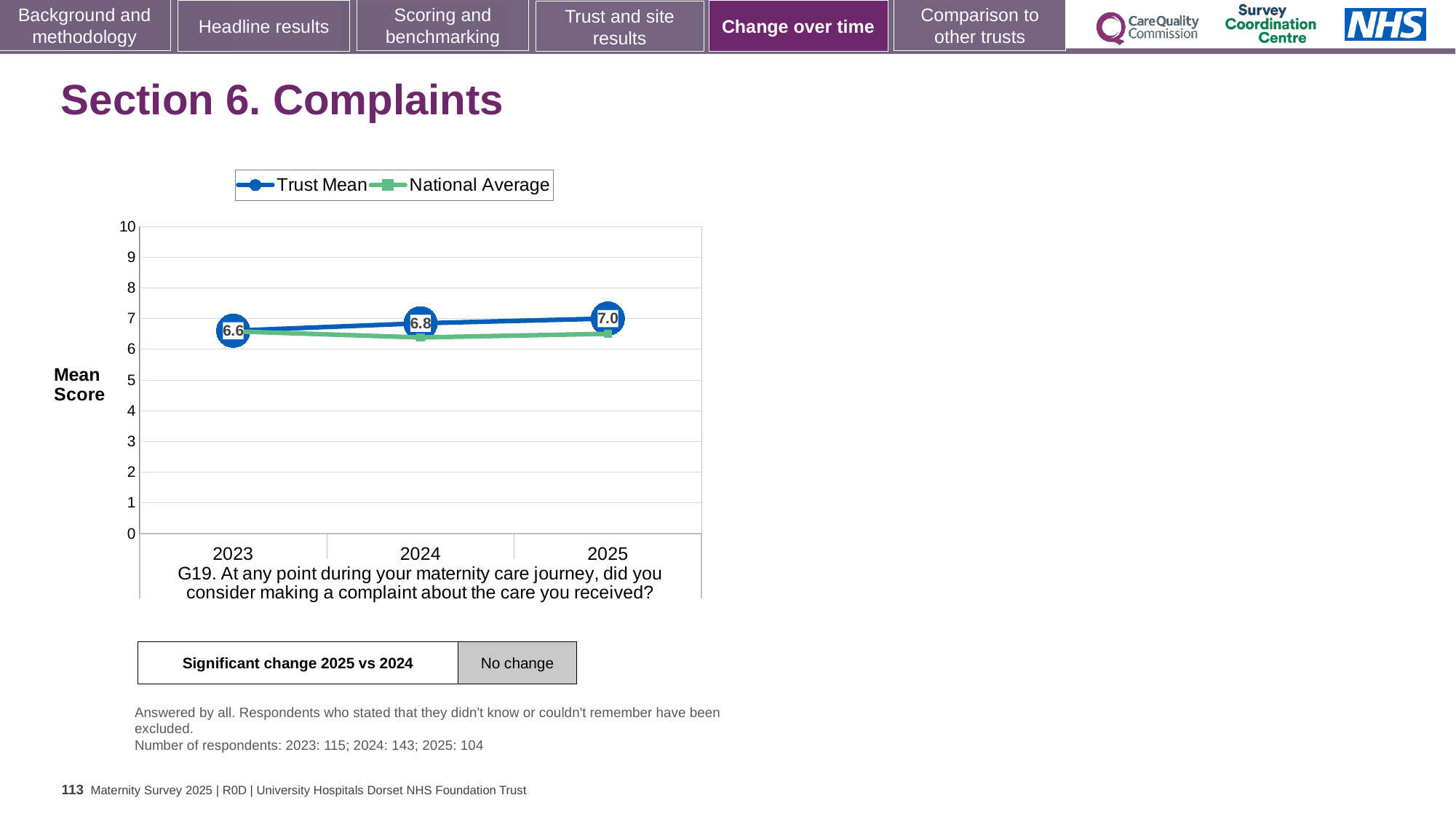
In which year is the Trust Mean score highest? 2025 Which is larger in 2025, the Trust Mean or the National Average? Trust Mean What is the Trust Mean score for 2025? 7.0 Is the National Average value for 2024 greater or less than 7? less What is the difference between the Trust Mean score in 2025 and in 2023? 0.4 Does the Trust Mean rise or fall from 2023 to 2025? rise What is the Trust Mean score for 2023? 6.6 How many years are plotted on the x axis? 3 Is the National Average value for 2023 greater or less than 6? greater How many series does the legend list? 2 In which year is the Trust Mean score lowest? 2023 What is the Trust Mean score for 2024? 6.8